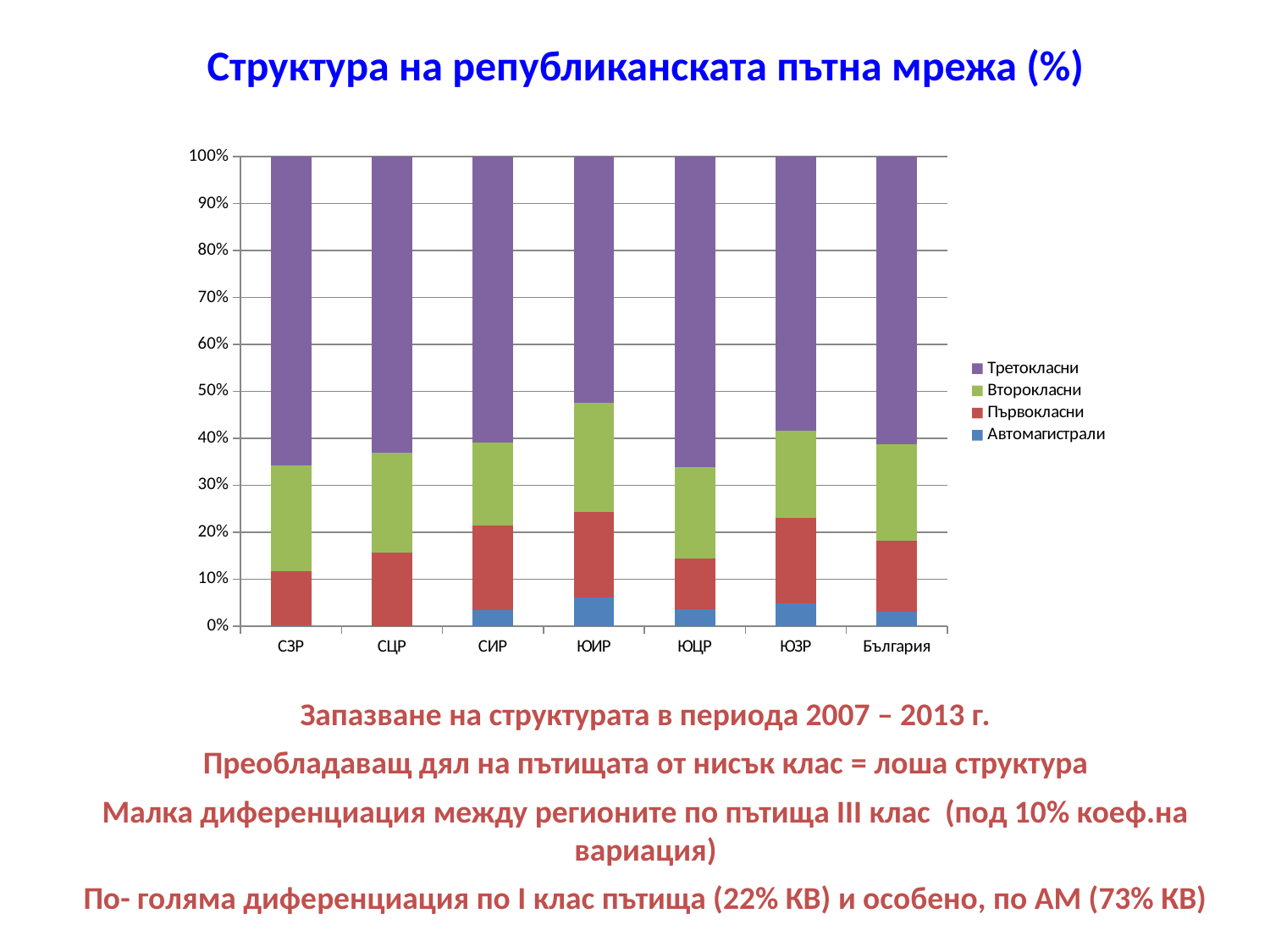
What is the title of the chart? Структура на републиканската пътна мрежа (%) Is the Третокласни share for СЗР greater or less than 60%? greater How many series does the chart legend list? 4 Which series is shown at the top of each stacked bar? Третокласни How many categories are shown on the x axis of the chart? 7 Which is larger, the Третокласни share for ЮЗР or for ЮИР? ЮЗР What kind of chart is shown on the slide? Stacked bar chart Is the Първокласни share for СЗР greater or less than 20%? less Which category has the smallest Третокласни share? ЮИР Which category has the largest Автомагистрали share? ЮИР Which is larger, the Автомагистрали share for ЮИР or for СИР? ЮИР Is the Автомагистрали share for ЮИР greater or less than 10%? less